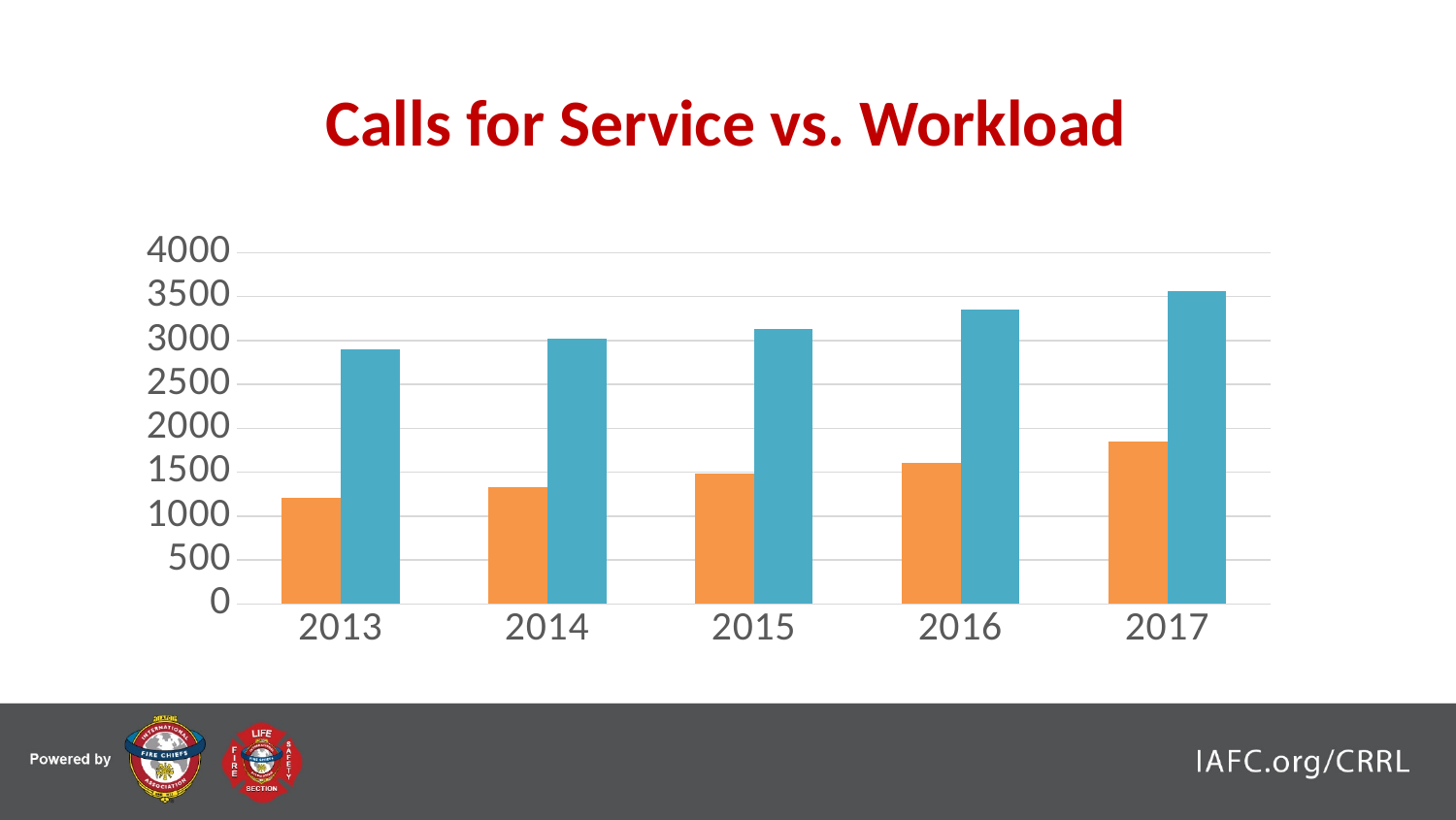
What is the title of the chart? Calls for Service vs. Workload Do the blue bars rise or fall from 2013 to 2017? rise Is the orange bar for 2017 greater or less than 1500? greater Is the orange bar for 2013 greater or less than 1500? less How many data series (bar colours) are plotted for each year? 2 How many years are shown on the x axis of the chart? 5 Is the blue bar for 2017 greater or less than 3000? greater Which year has the lowest orange bar? 2013 In 2015, which bar is taller, the orange one or the blue one? blue Which year has the highest blue bar? 2017 Do the orange bars rise or fall from 2013 to 2017? rise What kind of chart is shown on the slide? bar chart